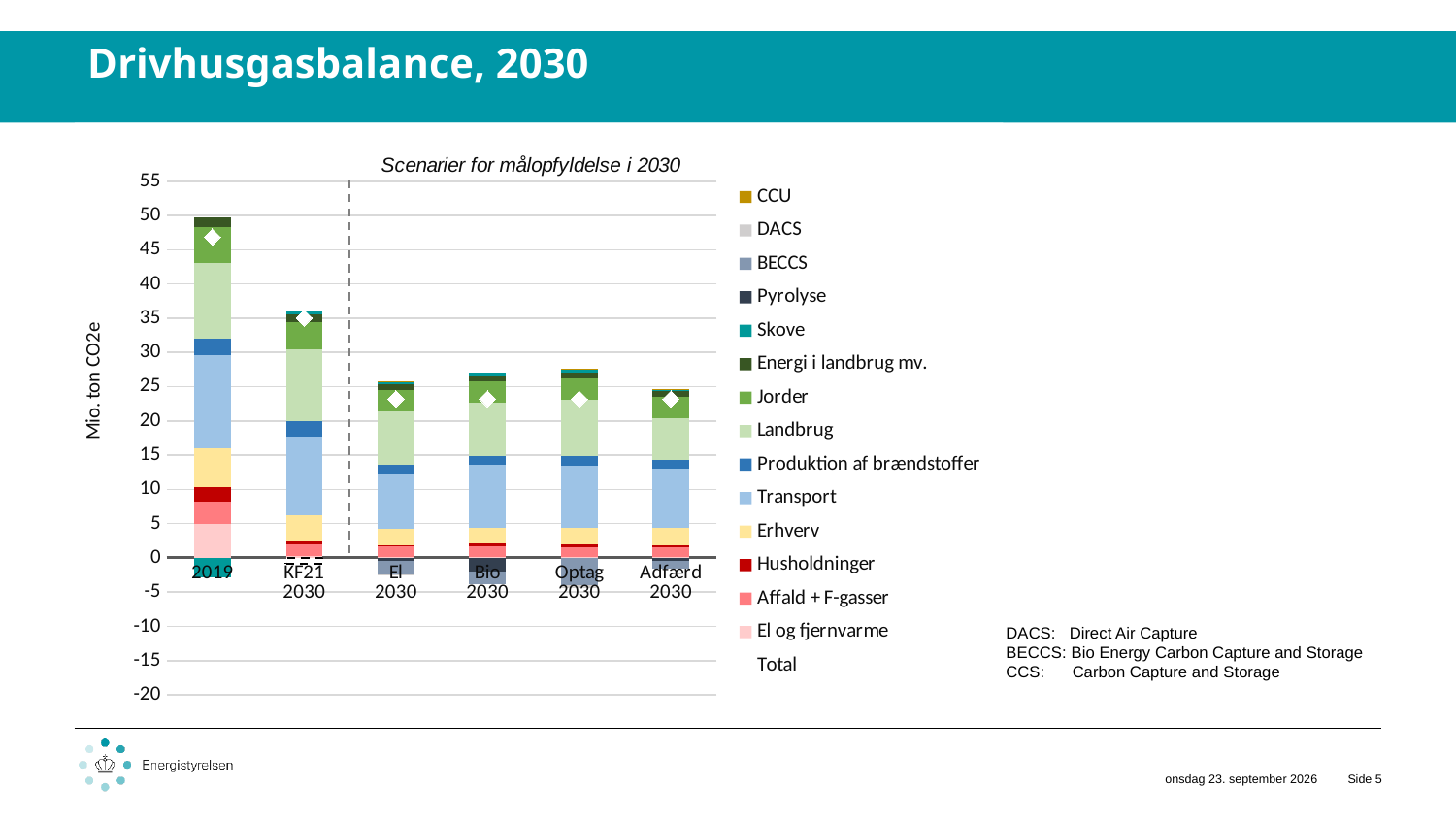
How many entries does the chart's legend list? 15 Is the Total marker for Adfærd 2030 greater or less than 20? greater Is the Total marker for KF21 2030 greater or less than 30? greater Which category has the highest Total marker? 2019 Is the Total marker for El 2030 greater or less than 30? less Which has the larger Total marker, 2019 or KF21 2030? 2019 What is the label on the chart's vertical axis? Mio. ton CO2e Do the Total markers rise or fall from 2019 to El 2030? fall How many categories are shown along the x axis of the chart? 6 What kind of chart is shown on the slide? Stacked bar chart Which category has the tallest stacked bar? 2019